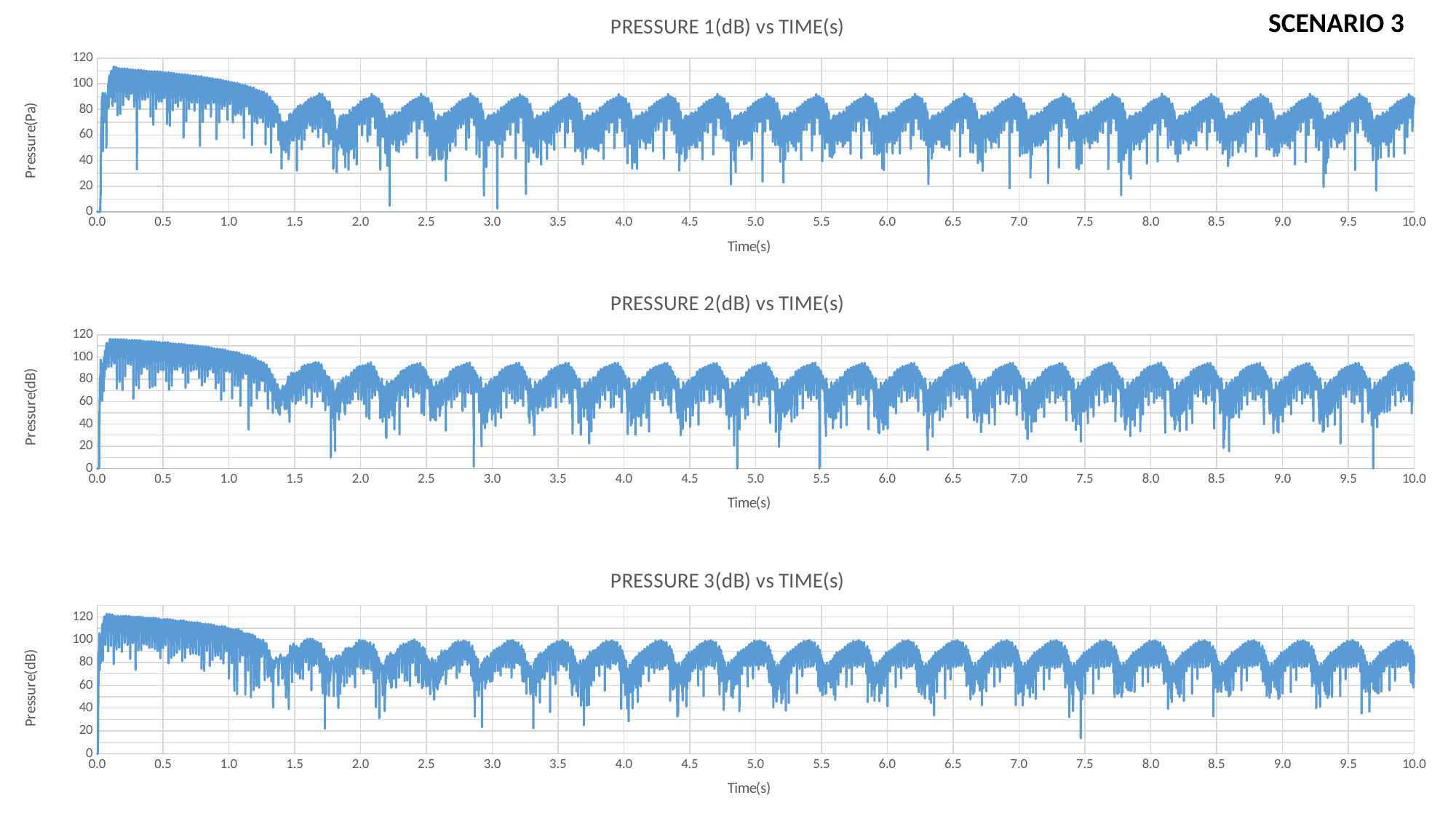
In the bottom chart, PRESSURE 3(dB) vs TIME(s), is the highest value reached near 0.0 s greater or less than 100? greater What is the last time value labelled on the x-axis of the middle chart, PRESSURE 2(dB) vs TIME(s)? 10.0 How many charts are shown on the slide? 3 In the middle chart, PRESSURE 2(dB) vs TIME(s), is the peak value near 0.1 s greater or less than 100? greater In the top chart, PRESSURE 1(dB) vs TIME(s), do the peak values rise or fall between 0.5 s and 1.5 s? fall What is the title of the middle chart? PRESSURE 2(dB) vs TIME(s) How many tick labels are shown on the x-axis of the top chart, PRESSURE 1(dB) vs TIME(s)? 21 In the top chart, PRESSURE 1(dB) vs TIME(s), is the peak value reached near 0.1 s greater or less than 100? greater What is the y-axis label of the top chart, PRESSURE 1(dB) vs TIME(s)? Pressure(Pa) What kind of chart is the top chart, PRESSURE 1(dB) vs TIME(s)? line chart What is the maximum value shown on the y-axis of the bottom chart, PRESSURE 3(dB) vs TIME(s)? 120